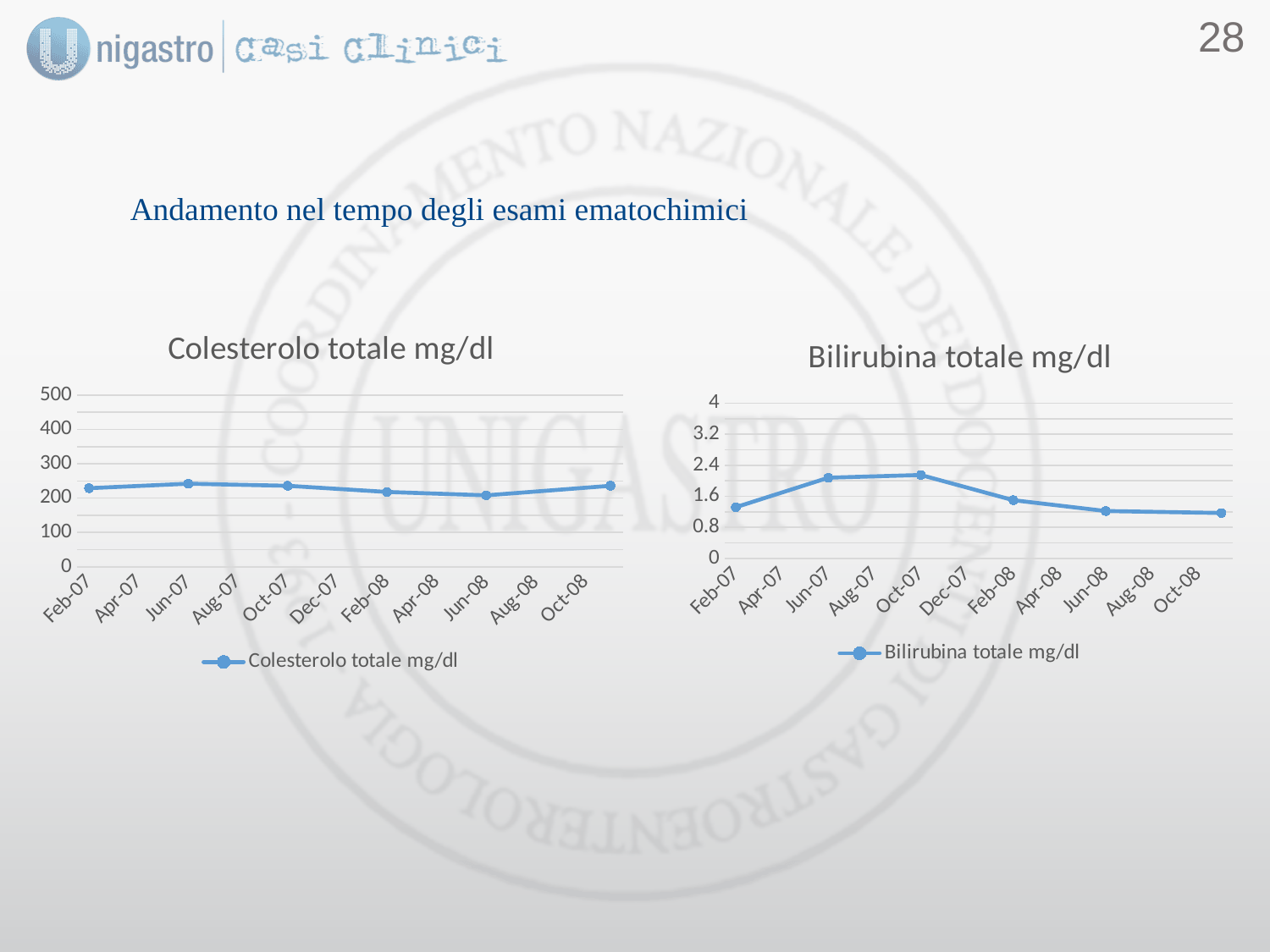
In the "Bilirubina totale mg/dl" chart, do the values rise or fall from Oct-07 to Oct-08? fall In the "Colesterolo totale mg/dl" chart, is the value for Feb-07 greater or less than 200? greater How many series does the legend of the "Colesterolo totale mg/dl" chart list? 1 In the "Bilirubina totale mg/dl" chart, is the value for Jun-07 greater or less than 1.6? greater In the "Colesterolo totale mg/dl" chart, how many data points are plotted? 6 In the "Bilirubina totale mg/dl" chart, is the value for Oct-08 greater or less than 0.8? greater In the "Bilirubina totale mg/dl" chart, how many data points are plotted? 6 What kind of chart is the "Bilirubina totale mg/dl" chart? line chart What is the title of the chart on the right side of the slide? Bilirubina totale mg/dl In the "Bilirubina totale mg/dl" chart, which is larger, the value for Jun-07 or the value for Feb-07? Jun-07 What kind of chart is the "Colesterolo totale mg/dl" chart? line chart